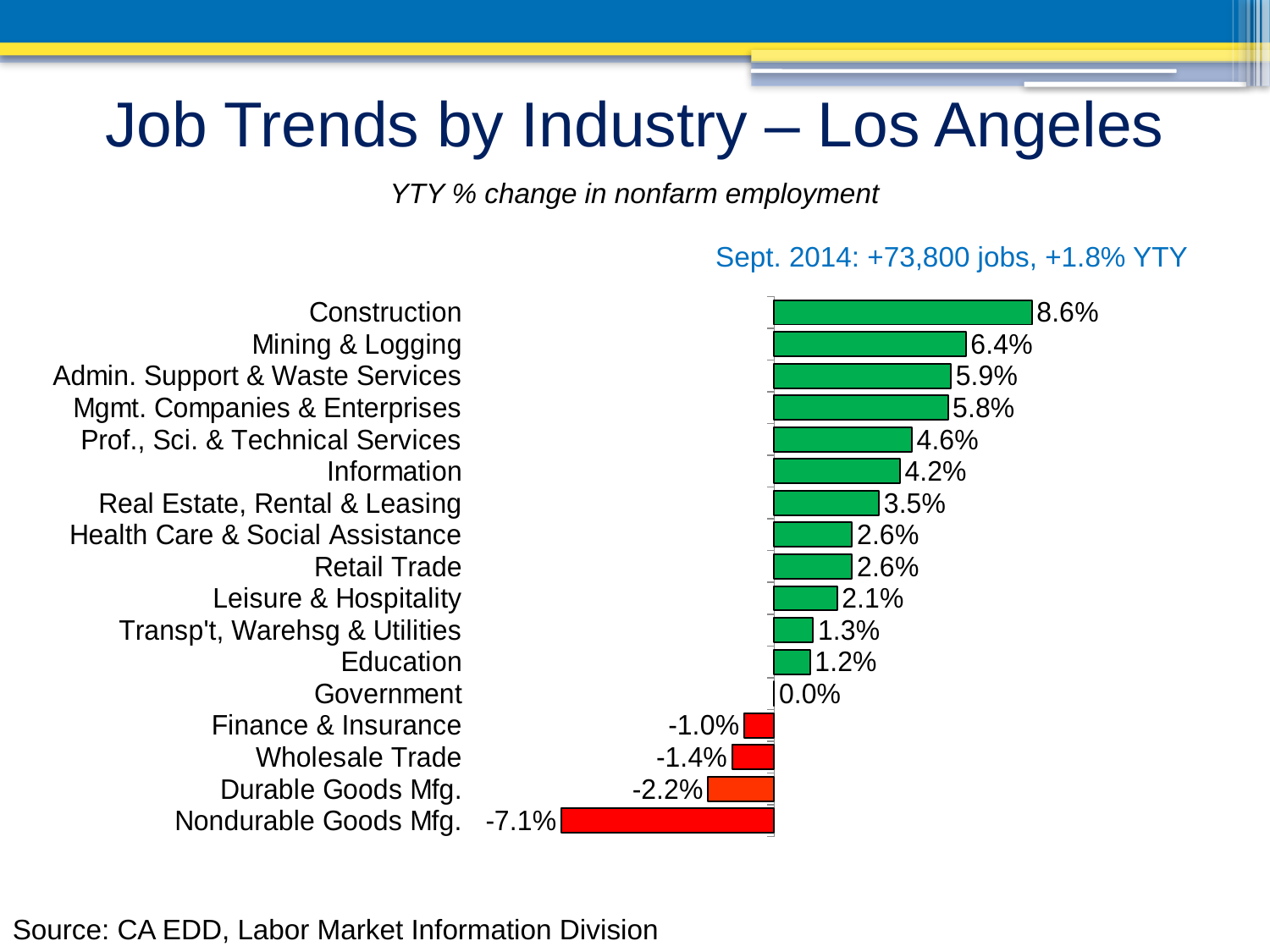
What is the difference between the values for Construction and Mining & Logging? 2.2% What is the value shown for Information? 4.2% What colour are the bars for industries with negative values? Red Which industry has the highest YTY % change? Construction How many industries are shown in the chart? 17 What kind of chart is shown on the slide? Bar chart What is the value shown for Wholesale Trade? -1.4% What is the value shown for Government? 0.0% How many industries show a negative YTY % change? 4 Which industry has the lowest YTY % change? Nondurable Goods Mfg. What is the YTY % change in nonfarm employment for Construction? 8.6% Which is larger, the value for Leisure & Hospitality or the value for Real Estate, Rental & Leasing? Real Estate, Rental & Leasing